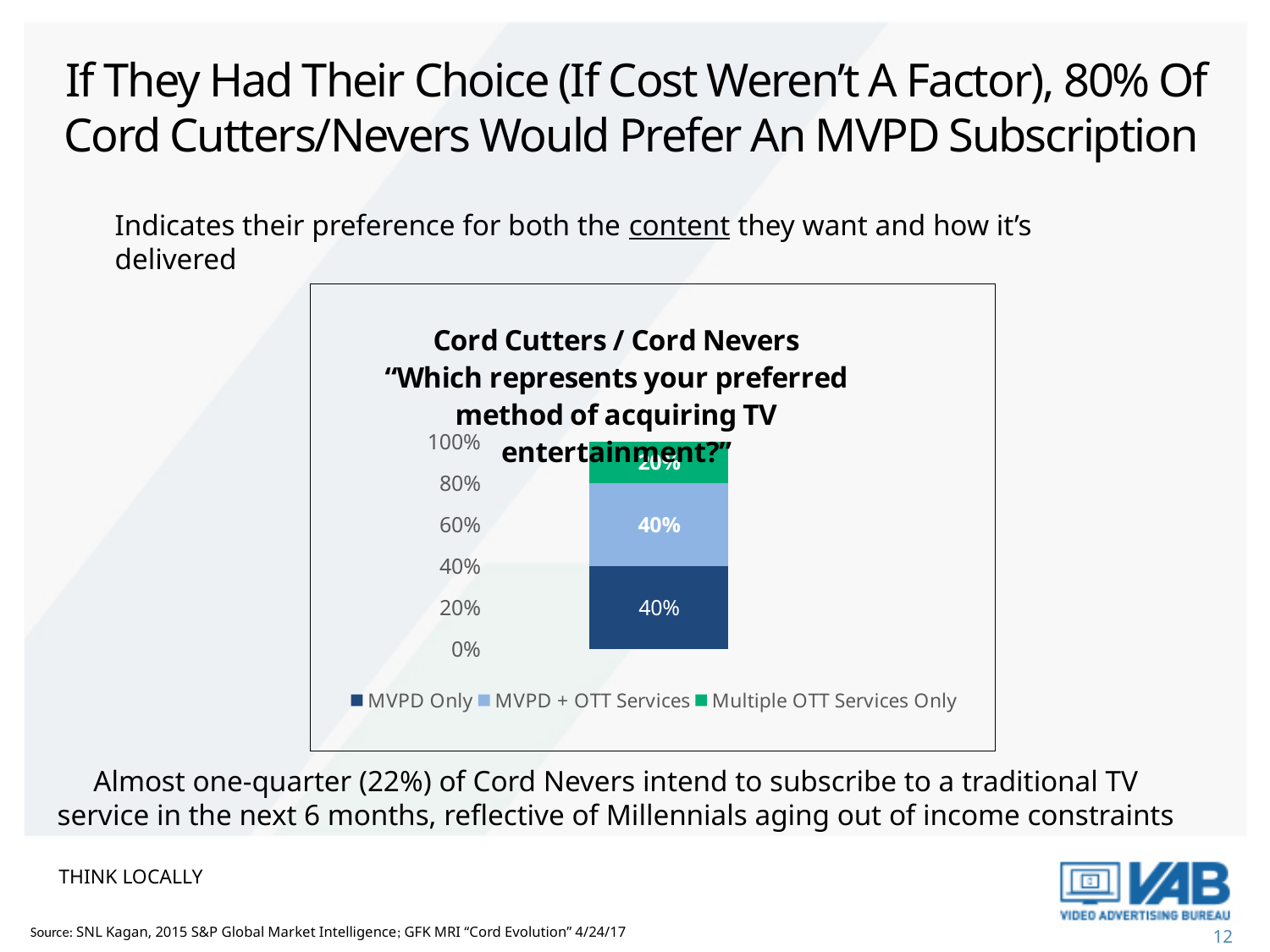
What value is shown for the MVPD + OTT Services segment? 40% What is the total of the stacked bar? 100% What percentage of Cord Cutters / Cord Nevers prefer MVPD Only? 40% What kind of chart is shown on the slide? Stacked bar chart Is the value for Multiple OTT Services Only greater or less than 40%? less How many bars are plotted in the chart? 1 What percentage is shown for Multiple OTT Services Only? 20% How many series does the legend list? 3 What is the difference between the MVPD Only value and the Multiple OTT Services Only value? 20% Which legend entry is shown in green? Multiple OTT Services Only Which series has the smallest share in the stacked bar? Multiple OTT Services Only Which is larger, the MVPD + OTT Services segment or the Multiple OTT Services Only segment? MVPD + OTT Services